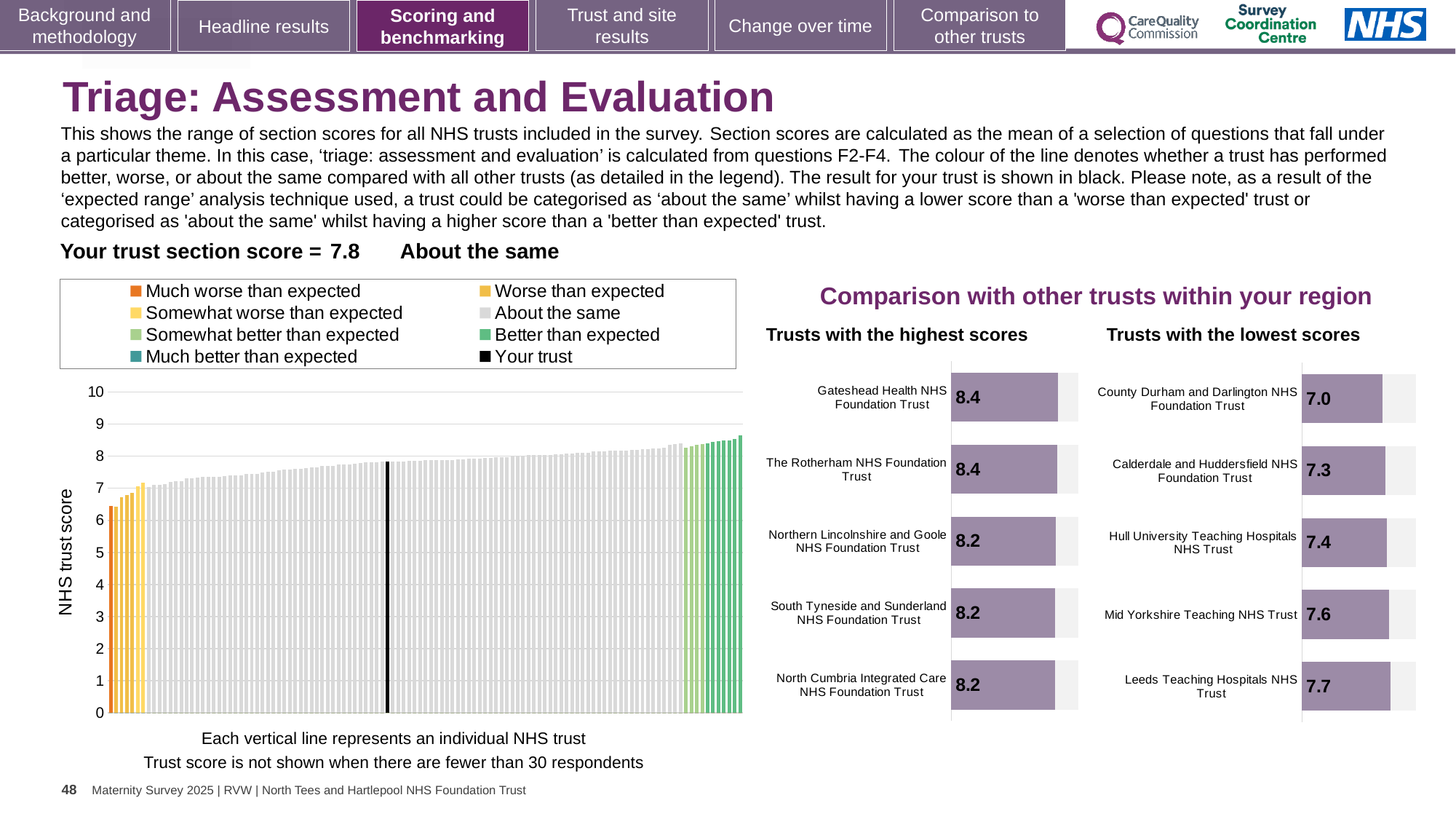
In the 'Trusts with the lowest scores' chart, which trust has the lowest score? County Durham and Darlington NHS Foundation Trust How many entries does the legend of the main 'NHS trust score' chart list? 8 In the 'Trusts with the lowest scores' chart, what is the score for County Durham and Darlington NHS Foundation Trust? 7.0 In the main 'NHS trust score' chart, is the value of the leftmost bar greater or less than 7? less In the 'Trusts with the lowest scores' chart, what is the score for Leeds Teaching Hospitals NHS Trust? 7.7 What kind of chart is the main 'NHS trust score' chart? bar chart How many trusts are shown in the 'Trusts with the highest scores' chart? 5 In the 'Trusts with the highest scores' chart, what is the score for Gateshead Health NHS Foundation Trust? 8.4 In the 'Trusts with the lowest scores' chart, which trust has the highest score? Leeds Teaching Hospitals NHS Trust In the main 'NHS trust score' chart, do the bar values rise or fall from left to right? rise What is the difference between the score for Gateshead Health NHS Foundation Trust in the 'Trusts with the highest scores' chart and the score for County Durham and Darlington NHS Foundation Trust in the 'Trusts with the lowest scores' chart? 1.4 In the 'Trusts with the lowest scores' chart, which has the larger score: Hull University Teaching Hospitals NHS Trust or Calderdale and Huddersfield NHS Foundation Trust? Hull University Teaching Hospitals NHS Trust